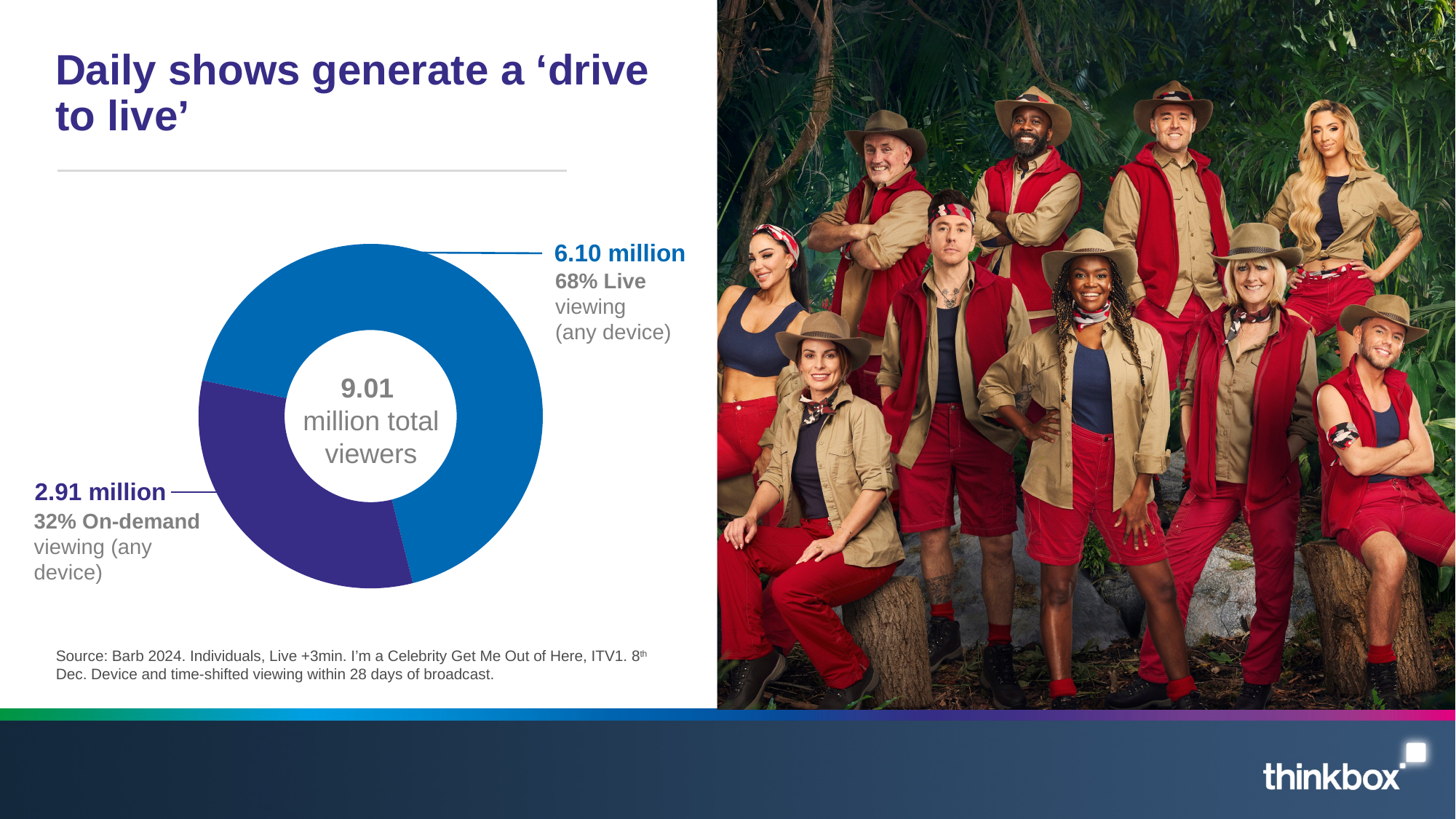
How many viewers does the chart attribute to live viewing (any device)? 6.10 million Which segment of the chart is the smallest? On-demand viewing (any device) Which segment is larger, live viewing or on-demand viewing? Live viewing What is the difference in millions of viewers between live viewing and on-demand viewing? 3.19 million What colour is the live viewing segment of the chart? Blue How many segments does the doughnut chart have? 2 What share of viewing is live viewing (any device)? 68% How many viewers does the chart attribute to on-demand viewing (any device)? 2.91 million What share of viewing is on-demand viewing (any device)? 32% What is the total number of viewers shown in the centre of the chart? 9.01 million What is the title of the slide containing the chart? Daily shows generate a 'drive to live' What kind of chart is shown on the slide? Doughnut chart